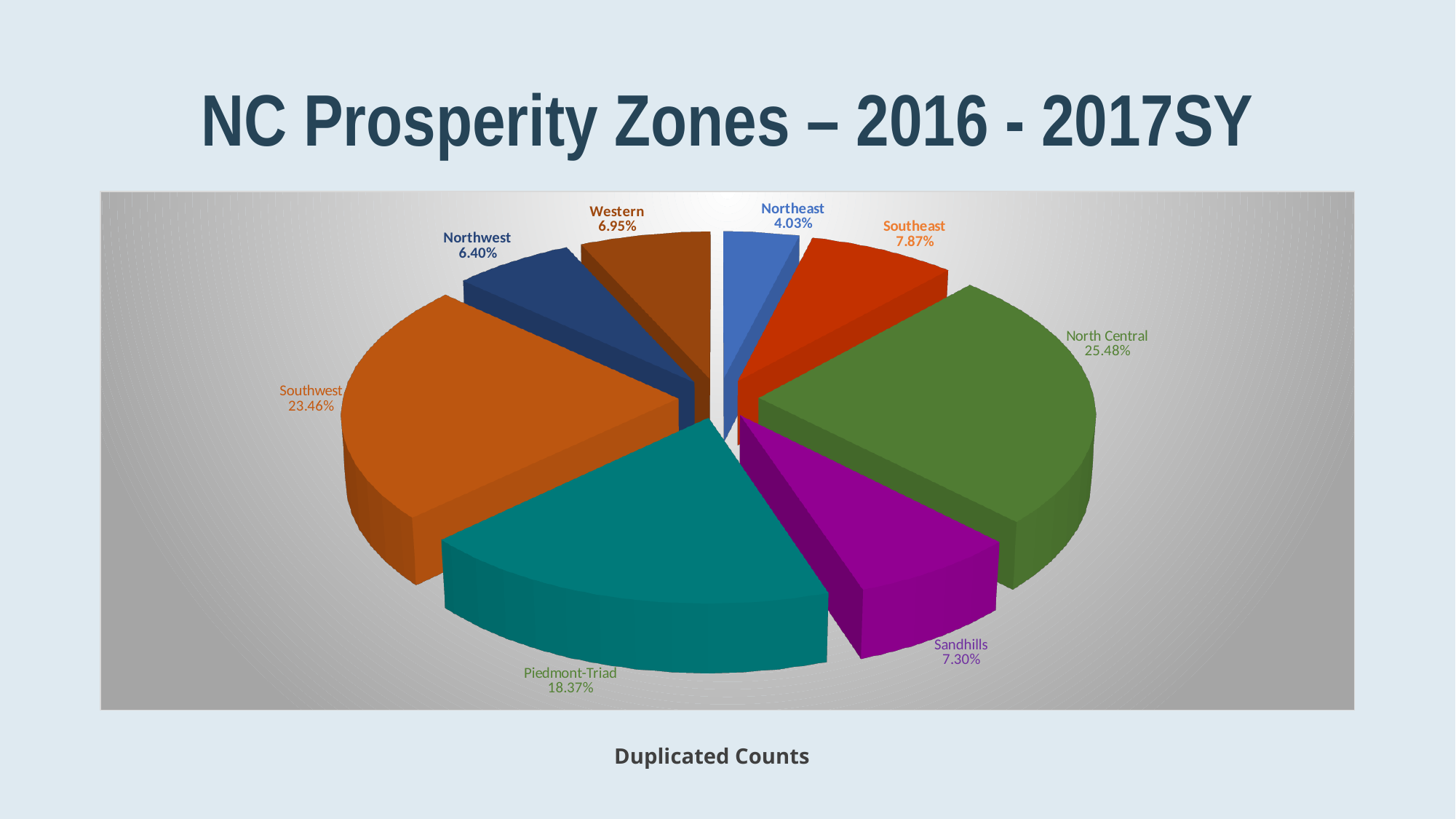
What share of the pie does Northeast have? 4.03% Which zone has the smallest share of the pie? Northeast What share of the pie does Piedmont-Triad have? 18.37% Which zone has the largest share of the pie? North Central What is the difference in percentage points between North Central and Southwest? 2.02 What share of the pie does Southwest have? 23.46% How many zones (slices) are shown in the pie chart? 8 Which is larger, the share for Western or the share for Northwest? Western What kind of chart is shown on the slide? Pie chart What share of the pie does Sandhills have? 7.30% What is the caption shown below the chart? Duplicated Counts What share of the pie does North Central have? 25.48%